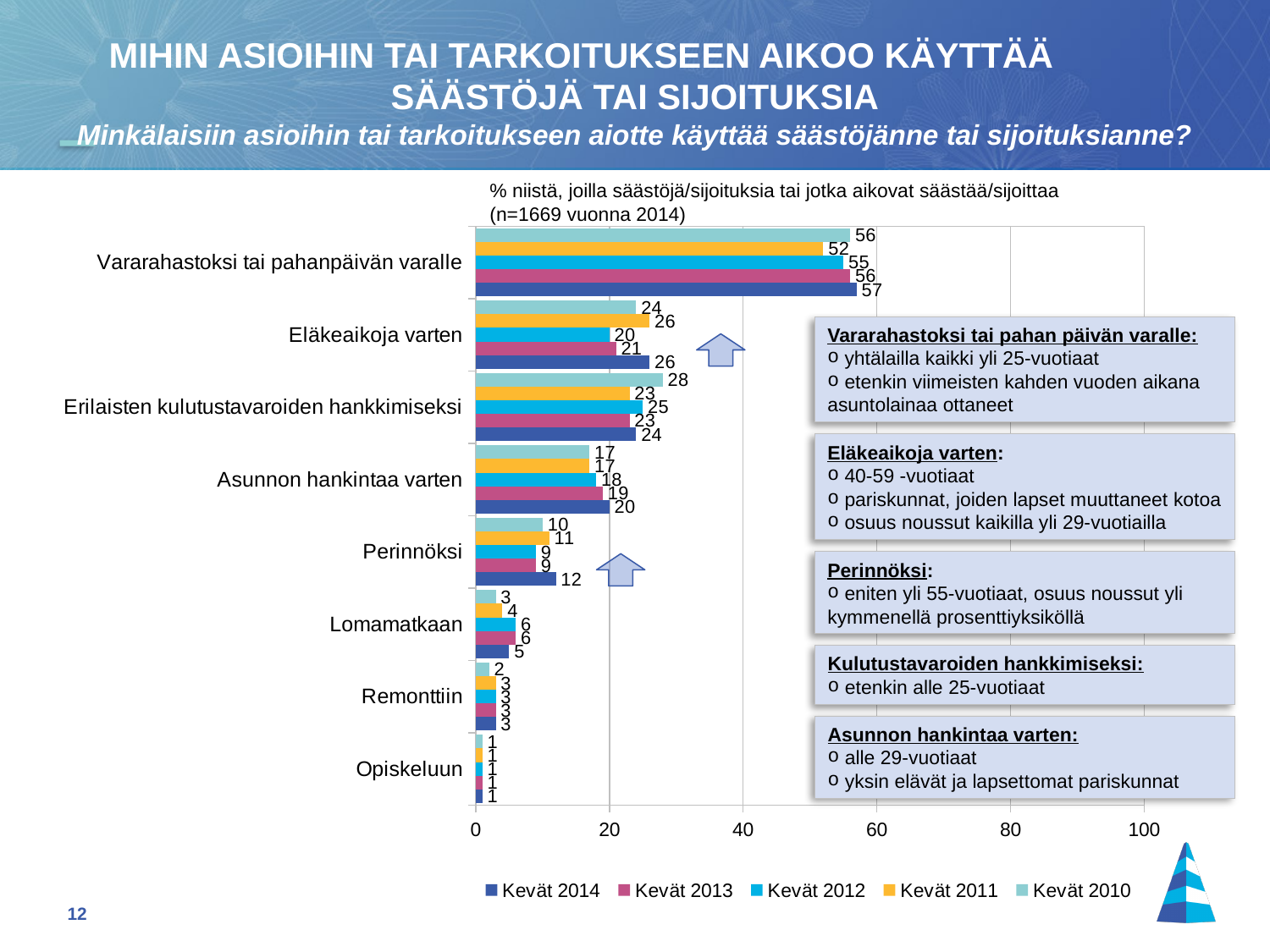
Is the Kevät 2014 value for 'Asunnon hankintaa varten' greater or less than 40? less For 'Perinnöksi', which is larger: the Kevät 2014 value or the Kevät 2012 value? Kevät 2014 Which series is shown in dark blue in the legend? Kevät 2014 What is the value for Kevät 2010 in the category 'Erilaisten kulutustavaroiden hankkimiseksi'? 28 Which category has the lowest value for Kevät 2014? Opiskeluun What is the value for Kevät 2014 in the category 'Vararahastoksi tai pahanpäivän varalle'? 57 How many categories are shown on the chart? 8 What is the value for Kevät 2011 in the category 'Eläkeaikoja varten'? 26 What is the difference between the Kevät 2014 and Kevät 2011 values for 'Vararahastoksi tai pahanpäivän varalle'? 5 Which category has the highest value for Kevät 2014? Vararahastoksi tai pahanpäivän varalle How many series does the legend list? 5 What kind of chart is shown on the slide? bar chart